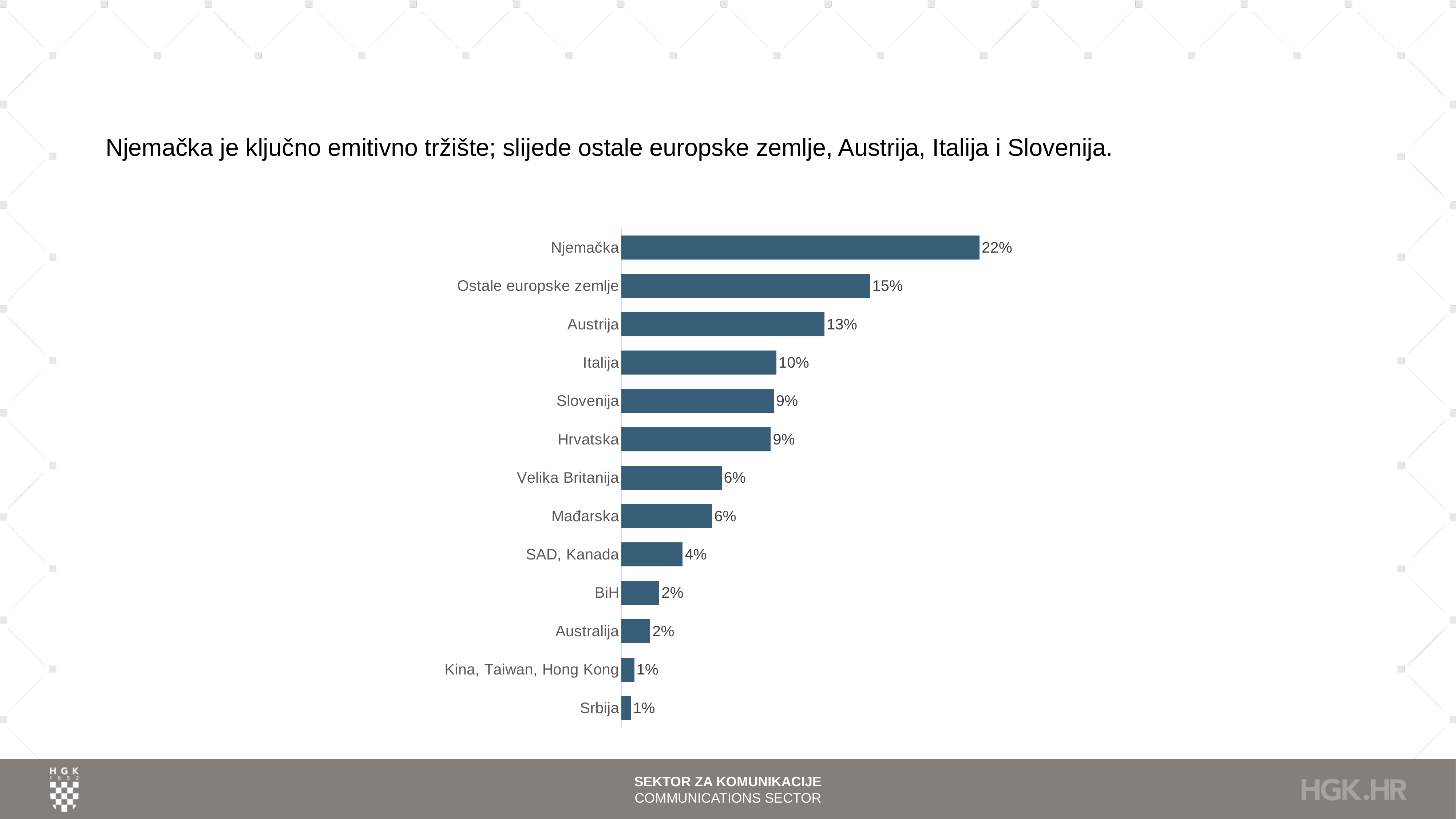
What is the difference between the values for Njemačka and Ostale europske zemlje? 7% Which category has the highest value? Njemačka How many categories are shown in the chart? 13 Which is larger, the value for Austrija or the value for Italija? Austrija What is the difference between the values for Italija and Mađarska? 4% What is the value for Slovenija? 9% What is the value for Austrija? 13% What kind of chart is shown on the slide? Bar chart Which is larger, the value for Velika Britanija or the value for BiH? Velika Britanija What is the value for SAD, Kanada? 4% What is the value for Njemačka? 22% What is the value for Kina, Taiwan, Hong Kong? 1%